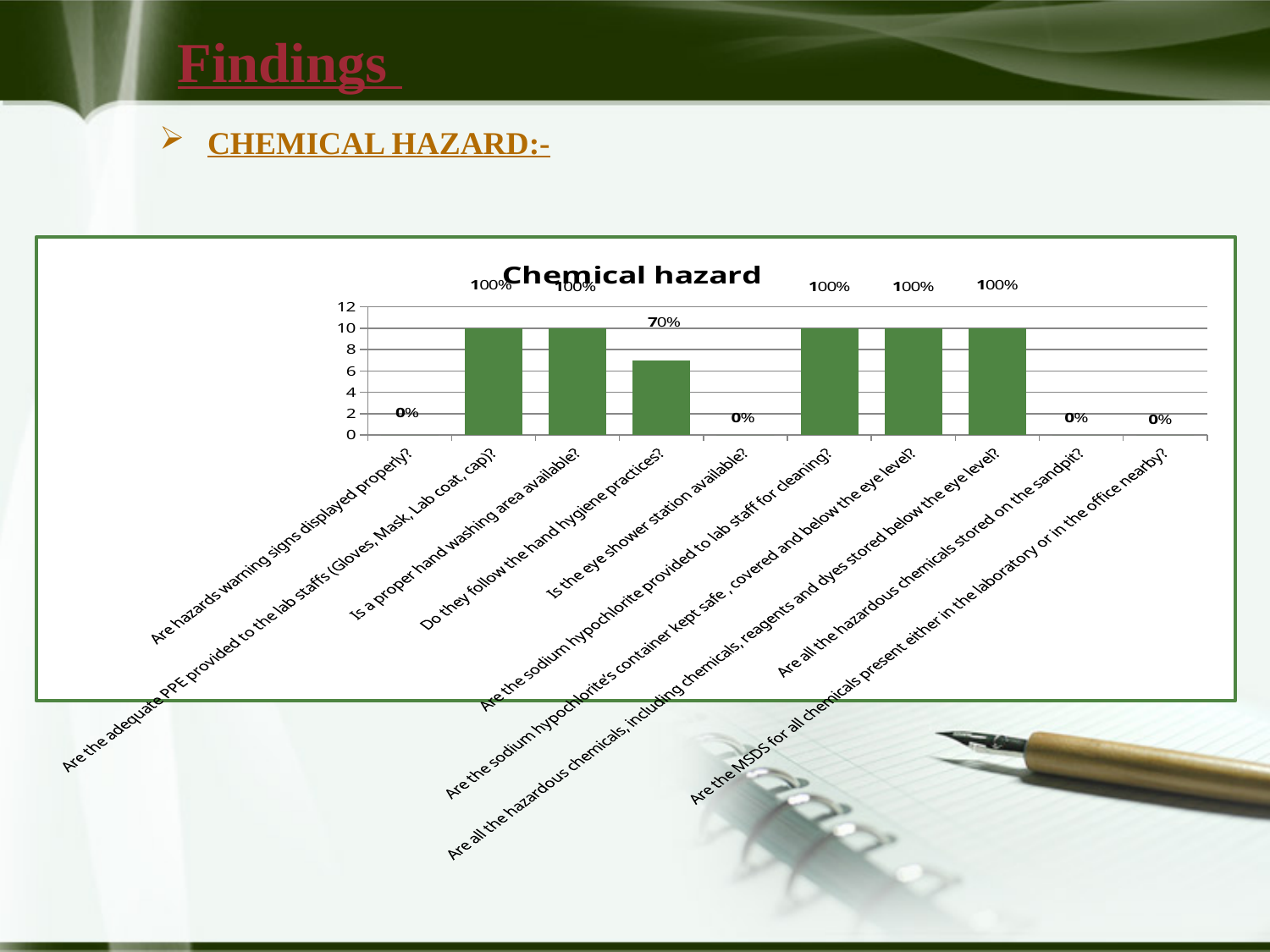
What is the data label for "Are hazards warning signs displayed properly?"? 0% What type of chart is shown on the slide? bar chart Is the bar for "Do they follow the hand hygiene practices?" greater or less than 8 on the y axis? less What is the data label for "Are the MSDS for all chemicals present either in the laboratory or in the office nearby?"? 0% How many categories have a data label of 100%? 5 What is the title of the chart? Chemical hazard Which is larger: the value for "Do they follow the hand hygiene practices?" or the value for "Is a proper hand washing area available?"? Is a proper hand washing area available? What is the difference between the value for "Are the adequate PPE provided to the lab staffs (Gloves, Mask, Lab coat, cap)?" and the value for "Do they follow the hand hygiene practices?"? 30% What is the data label for "Is the eye shower station available?"? 0% How many categories (questions) are plotted in the chart? 10 What is the data label for "Do they follow the hand hygiene practices?"? 70% What is the data label for "Is a proper hand washing area available?"? 100%